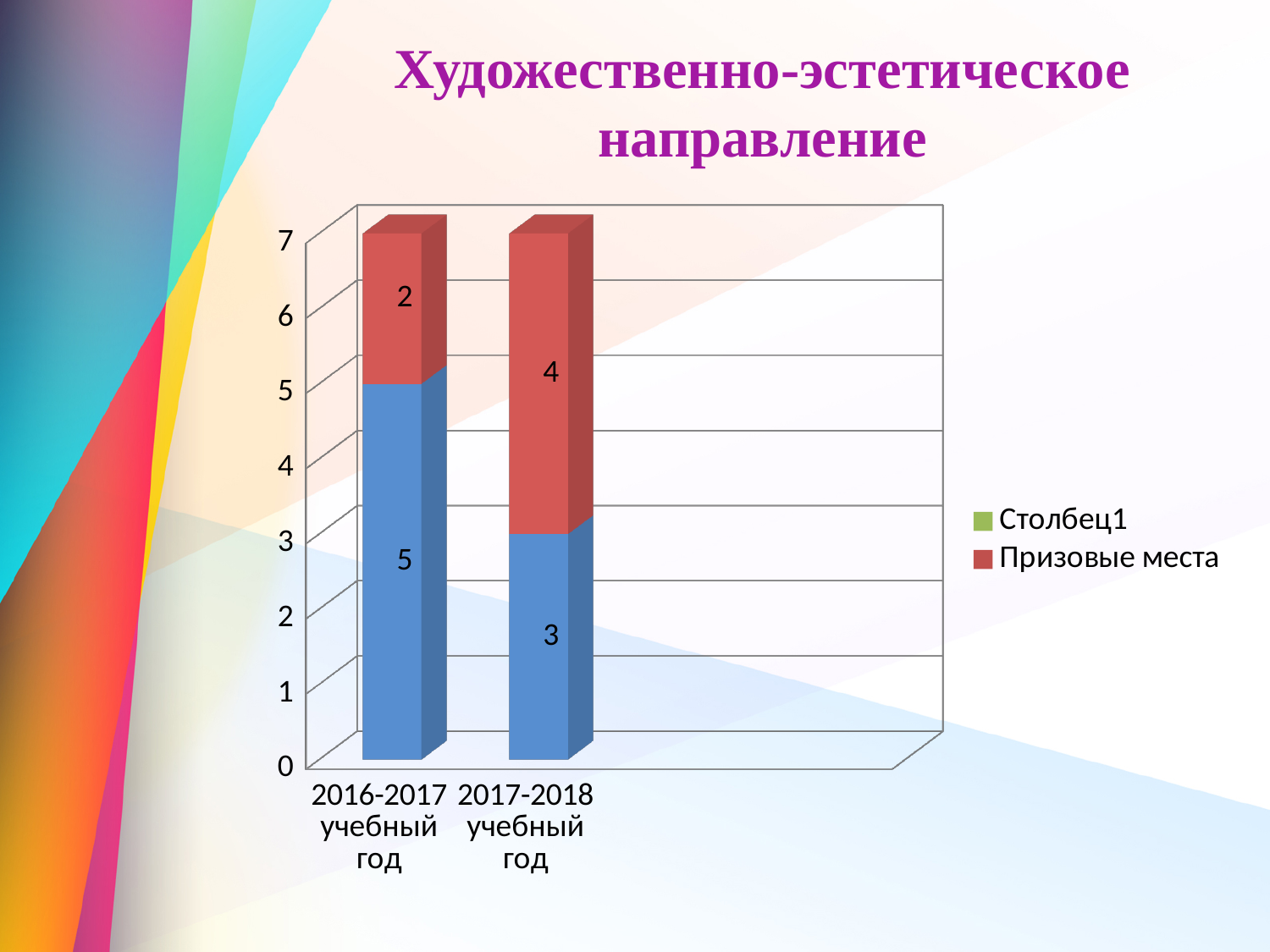
What is the value of "Призовые места" for 2016-2017 учебный год? 2 What is the total of the stacked bar for 2017-2018 учебный год? 7 By how much does "Призовые места" in 2017-2018 учебный год exceed that in 2016-2017 учебный год? 2 What value is printed on the blue segment of the bar for 2017-2018 учебный год? 3 Which academic year has the larger value for "Призовые места"? 2017-2018 учебный год How many academic years (categories) are shown on the x axis? 2 What kind of chart is shown on the slide? Stacked bar chart What is the total of the stacked bar for 2016-2017 учебный год? 7 What is the value of "Призовые места" for 2017-2018 учебный год? 4 What value is printed on the blue segment of the bar for 2016-2017 учебный год? 5 What is the title of the chart on the slide? Художественно-эстетическое направление How many series does the legend list? 2